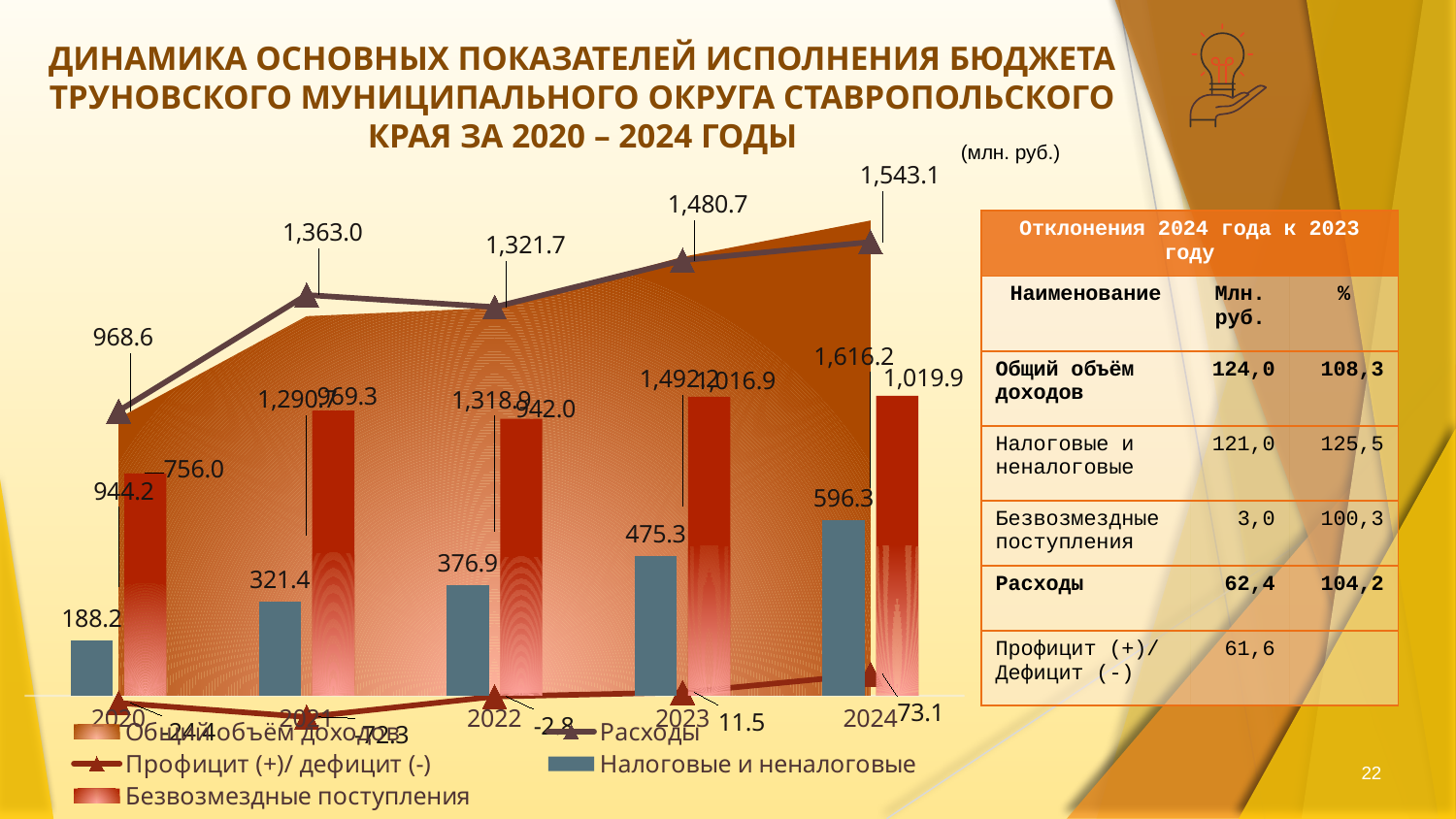
How many years are shown on the x axis of the chart? 5 Do the values of Налоговые и неналоговые rise or fall from 2020 to 2024? rise Which year has the larger value of Расходы, 2021 or 2022? 2021 What is the value of Безвозмездные поступления for 2020? 756.0 By how much did Налоговые и неналоговые increase from 2023 to 2024? 121.0 In which year is Расходы lowest? 2020 What is the value of Расходы for 2024? 1,543.1 What is the value of Расходы for 2021? 1,363.0 How many series does the chart legend list? 5 What is the value of Налоговые и неналоговые for 2024? 596.3 What is the value of Профицит (+)/ дефицит (-) for 2024? 73.1 In which year is Налоговые и неналоговые highest? 2024